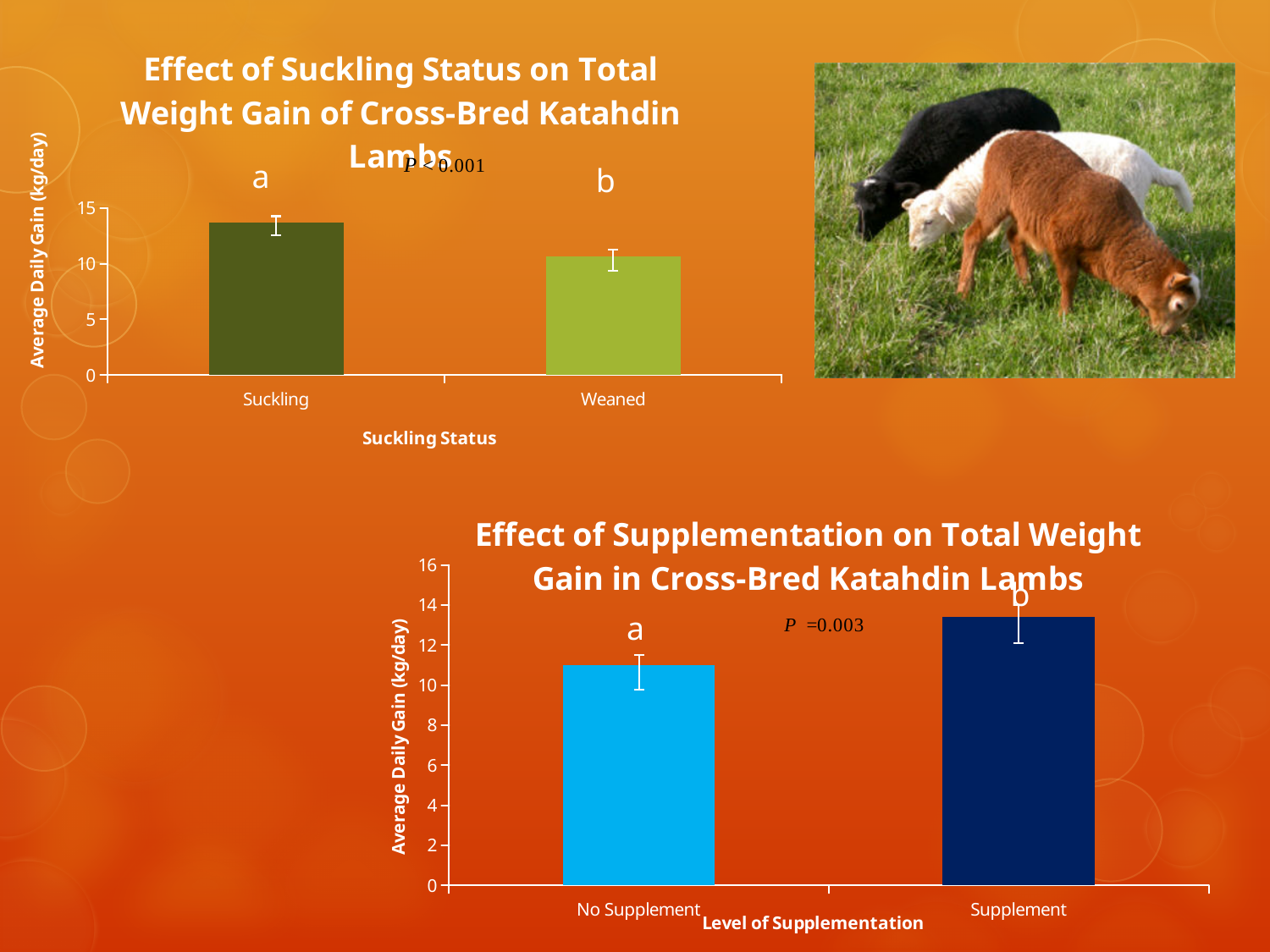
What P value is shown on the bottom chart? P =0.003 In the bottom chart, which level of supplementation has the higher average daily gain? Supplement In the top chart, which suckling status has the higher average daily gain? Suckling In the top chart, is the value for Suckling greater or less than 10? greater In the top chart, how many categories are shown on the x axis? 2 In the top chart, which suckling status has the lower average daily gain? Weaned In the bottom chart, is the value for No Supplement greater or less than 14? less What is the y-axis label of the bottom chart? Average Daily Gain (kg/day) In the top chart, is the value for Weaned greater or less than 15? less What kind of chart is the top chart? Bar chart In the bottom chart, is the value for No Supplement larger or smaller than the value for Supplement? smaller